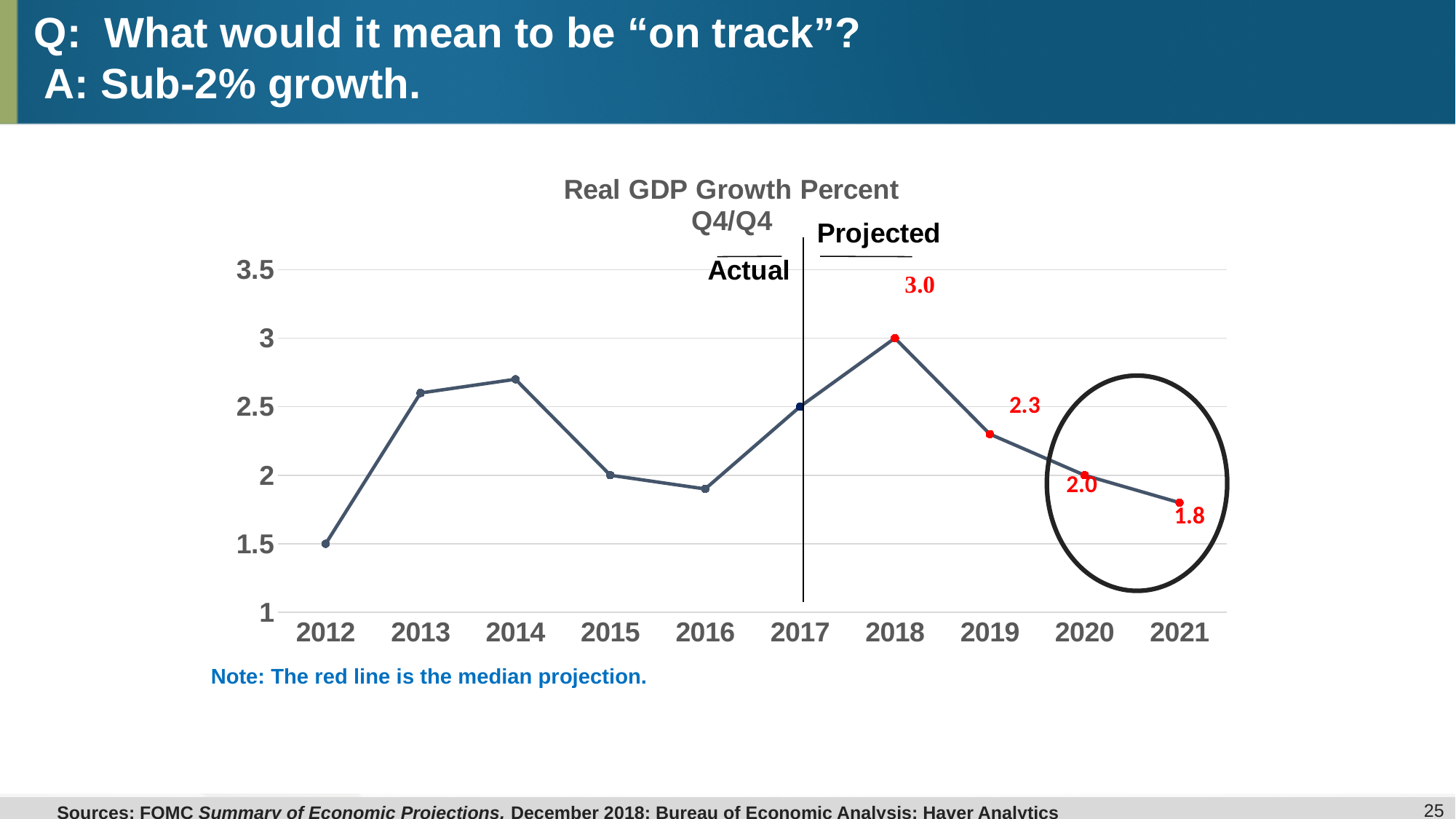
Is the value for 2014 greater or less than 2.5? greater Which year has the lowest real GDP growth on the chart? 2012 Which year has higher projected growth, 2019 or 2021? 2019 Which year has the highest real GDP growth on the chart? 2018 Do the projected values rise or fall from 2018 to 2021? Fall What is the difference between the projected growth for 2018 and 2021? 1.2 How many years are plotted on the x axis? 10 What is the projected real GDP growth for 2021? 1.8 What kind of chart is shown on the slide? Line chart What is the projected real GDP growth for 2018? 3.0 What is the projected real GDP growth for 2020? 2.0 What is the projected real GDP growth for 2019? 2.3